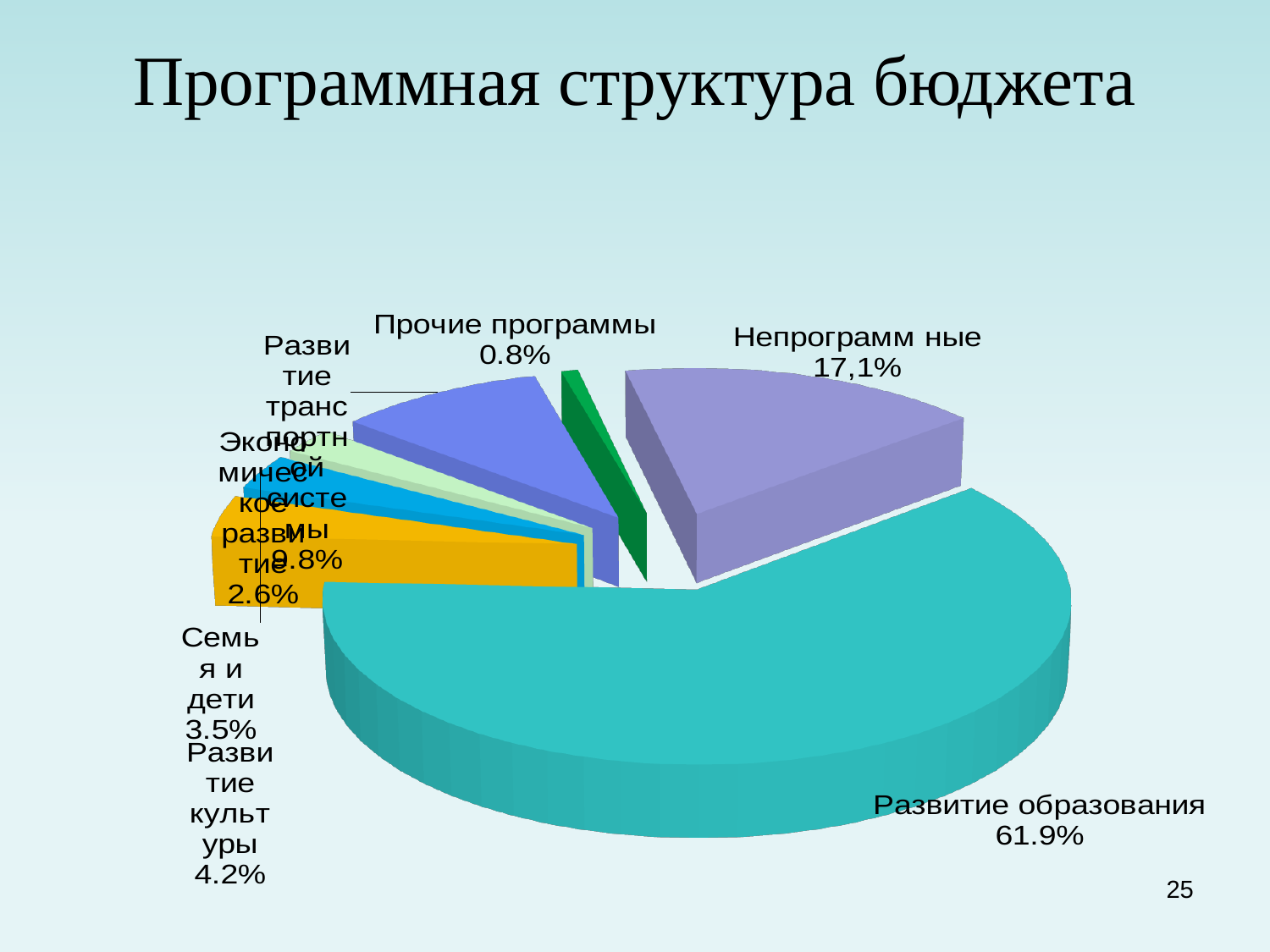
Which is larger: the share for Непрограммные or the share for Развитие культуры? Непрограммные Which category has the smallest share of the pie? Прочие программы What is the title of the chart on the slide? Программная структура бюджета What kind of chart is shown on the slide? pie chart What share is shown for Непрограммные? 17,1% What share is shown for Развитие транспортной системы? 9.8% What share is shown for Семья и дети? 3.5% Which category has the largest share of the pie? Развитие образования What share is shown for Развитие культуры? 4.2% How many slices does the pie chart have? 7 What share of the budget does Развитие образования have? 61.9% What share is shown for Прочие программы? 0.8%